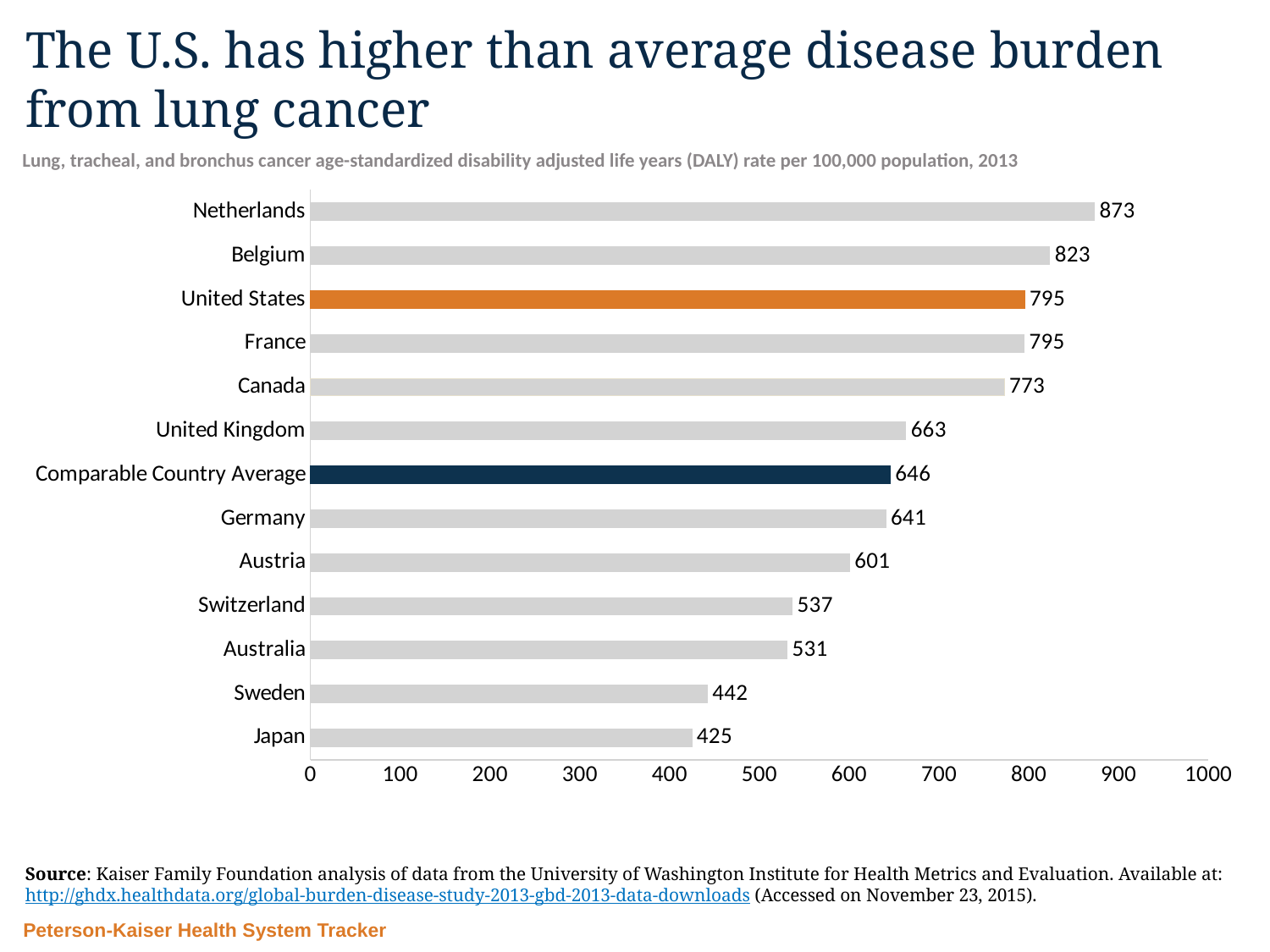
What is the DALY rate for the United States? 795 Which country has the highest DALY rate on the chart? Netherlands What is the difference between the Netherlands and Belgium values? 50 Which has a higher value, Canada or the United Kingdom? Canada Which bar is coloured orange? United States What is the value shown for the Comparable Country Average? 646 Which country has the lowest DALY rate on the chart? Japan What kind of chart is shown on the slide? Bar chart What is the difference between the United States value and the Comparable Country Average? 149 What is the value for Japan? 425 How many bars are shown on the chart? 13 Is the value for Sweden greater or less than 500? less